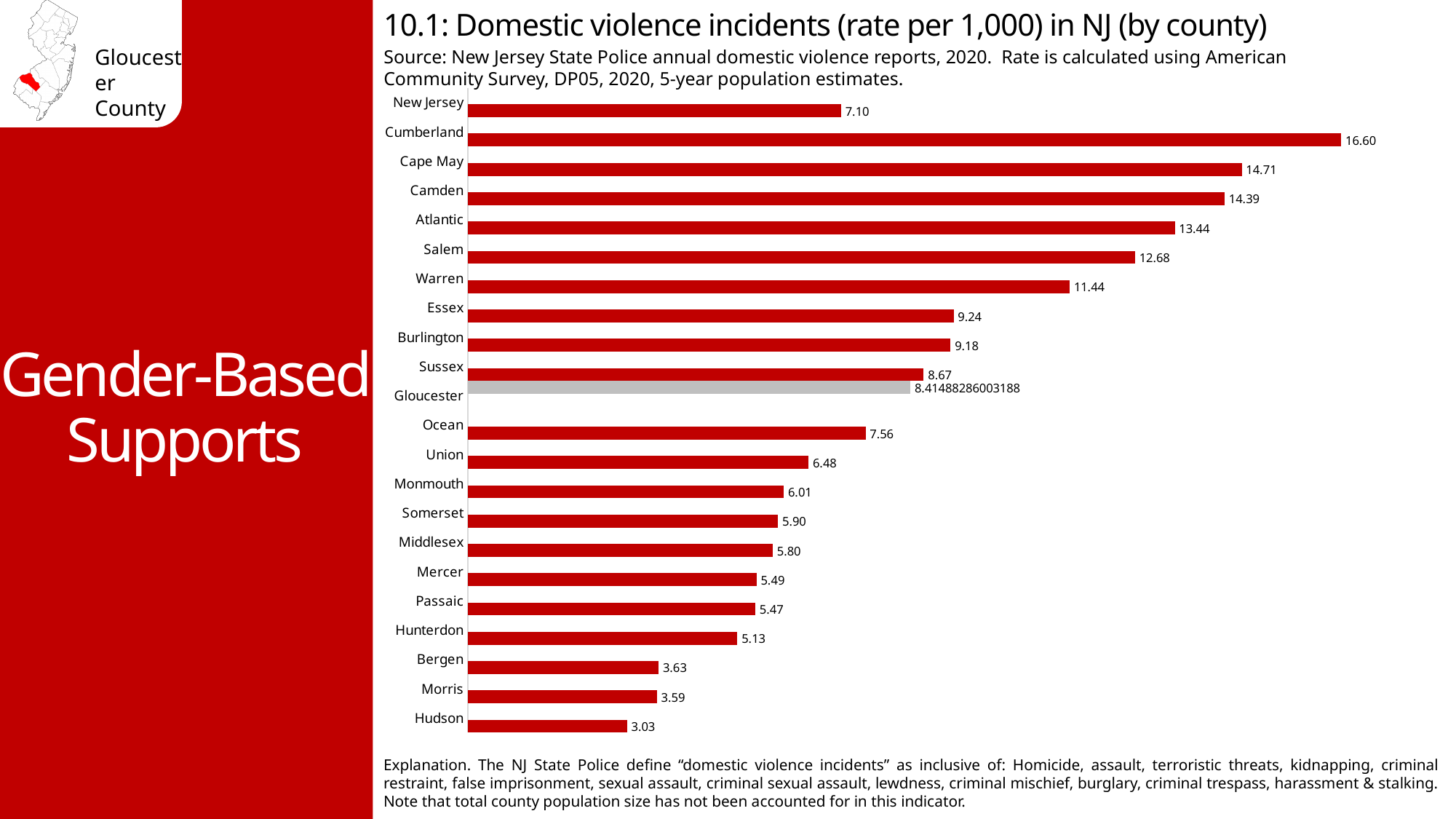
Which county has the highest domestic violence incident rate in the chart? Cumberland Which county's bar is coloured grey instead of red? Gloucester Which has a higher rate, Salem or Warren? Salem Which county has the lowest domestic violence incident rate in the chart? Hudson What type of chart is shown on the slide? Bar chart What is the value shown for New Jersey in the chart? 7.10 What is the difference between the rates for Cumberland and Hudson? 13.57 How many bars (categories) are plotted in the chart? 22 What is the domestic violence incident rate per 1,000 for Cumberland county? 16.60 What is the data label shown for Gloucester county? 8.41488286003188 What is the difference between the rates for Cape May and Camden? 0.32 What is the rate shown for Hunterdon county? 5.13